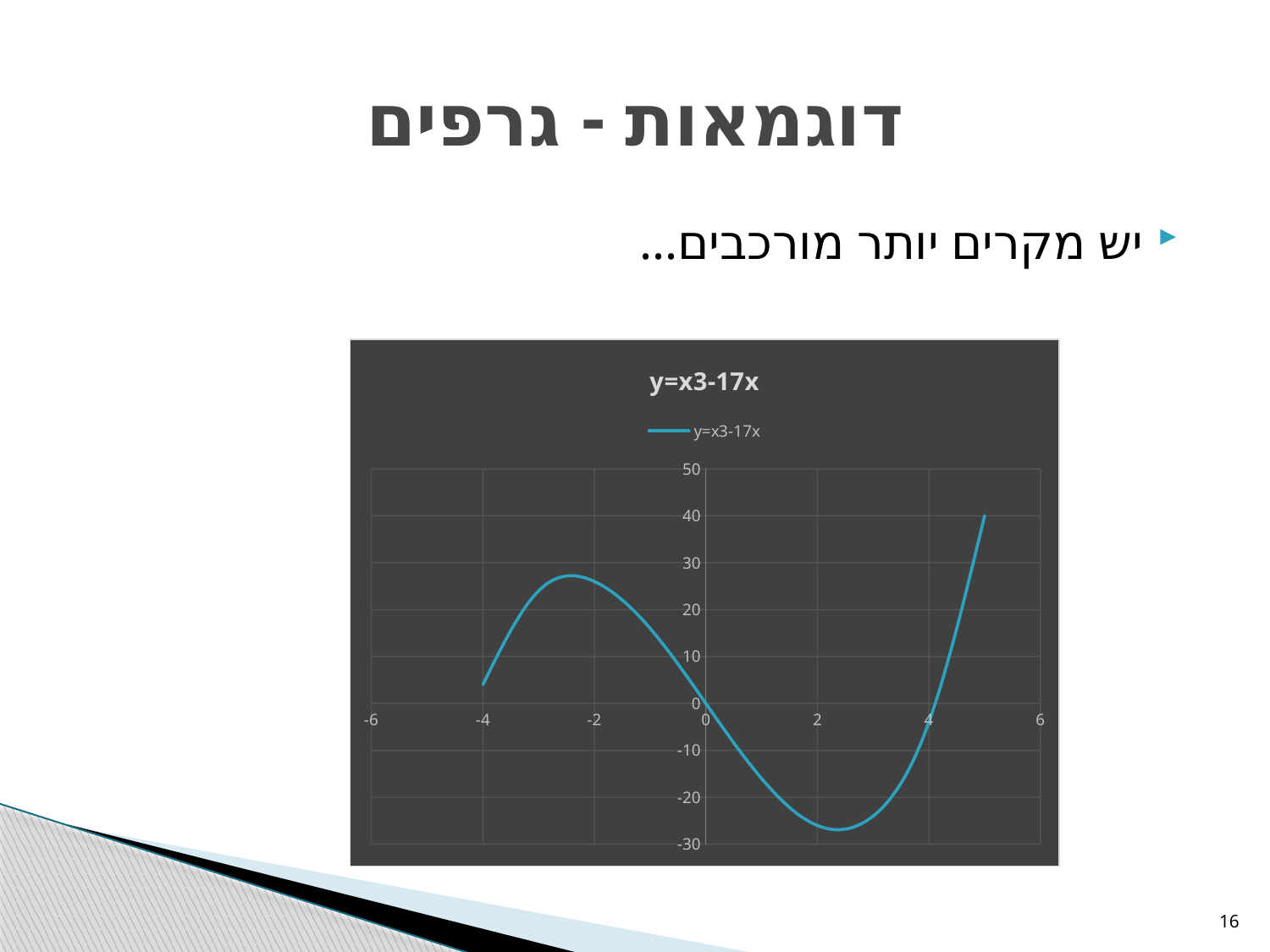
What is the y value of the curve at x = 0? 0 Is the highest point of the curve greater or less than 30? less What kind of chart is shown on the slide? line chart Is the lowest point of the curve greater or less than -20? less Is the value of the curve at x = 2 greater or less than -20? less What is the title of the chart? y=x3-17x Which is larger, the value of the curve at x = -2 or at x = 2? x = -2 What is the y value at the right end of the curve, where it stops? 40 Between x = 4 and the right end of the curve, does the curve rise or fall? rise How many series does the chart legend list? 1 Between x = 0 and x = 2, does the curve rise or fall? fall